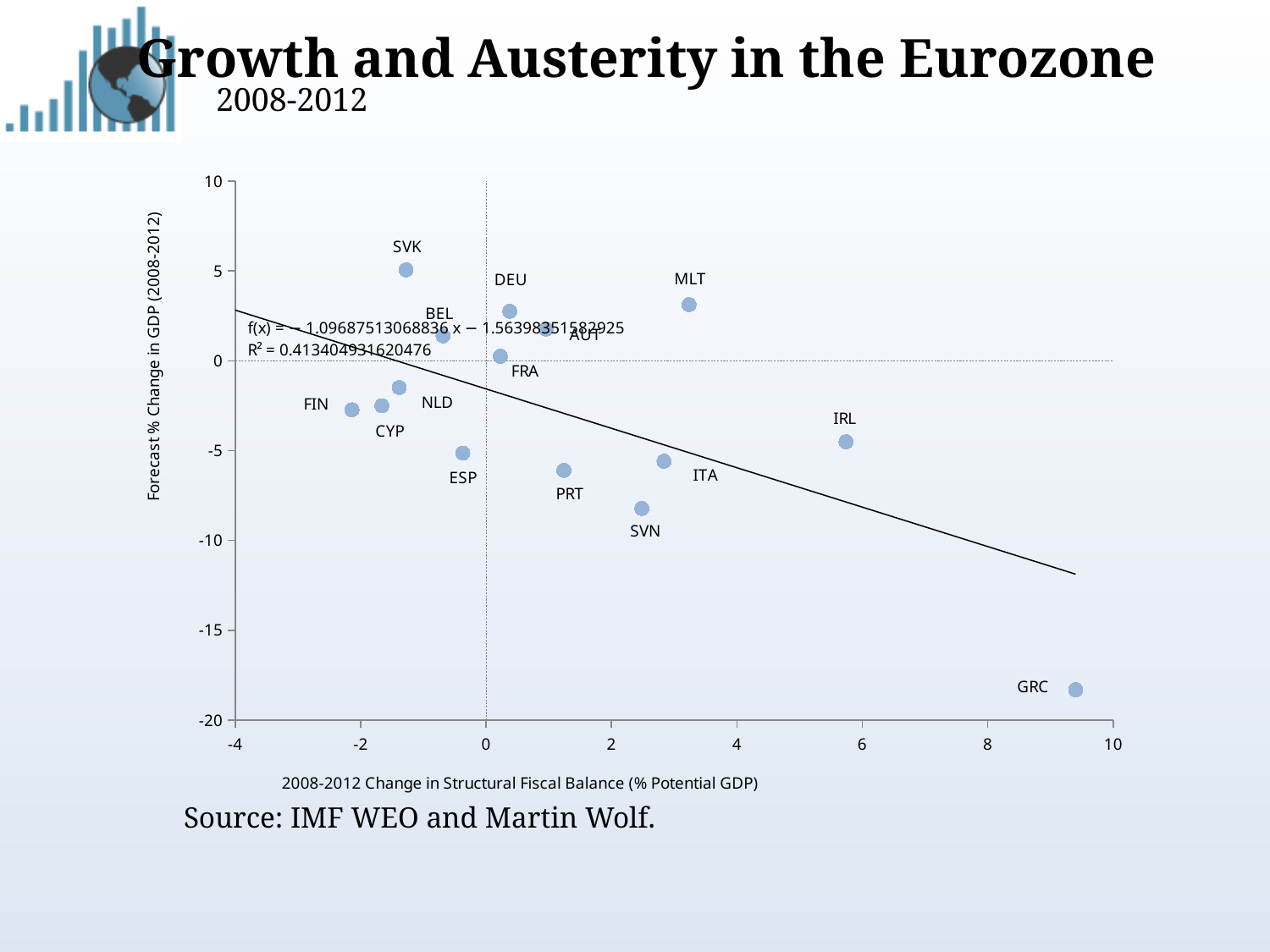
As the change in structural fiscal balance increases, does the fitted trend line rise or fall? Fall Which has a higher forecast % change in GDP, SVK or MLT? SVK What kind of chart is shown on the slide? Scatter chart Is the change in structural fiscal balance for IRL greater or less than 4? greater Is the forecast % change in GDP for GRC greater or less than -15? less Which country has the largest 2008-2012 change in structural fiscal balance? GRC Which country has the highest forecast % change in GDP? SVK What R² value is shown for the trend line? 0.413404931620476 Which country has the lowest forecast % change in GDP? GRC Is the forecast % change in GDP for SVN greater or less than -5? less